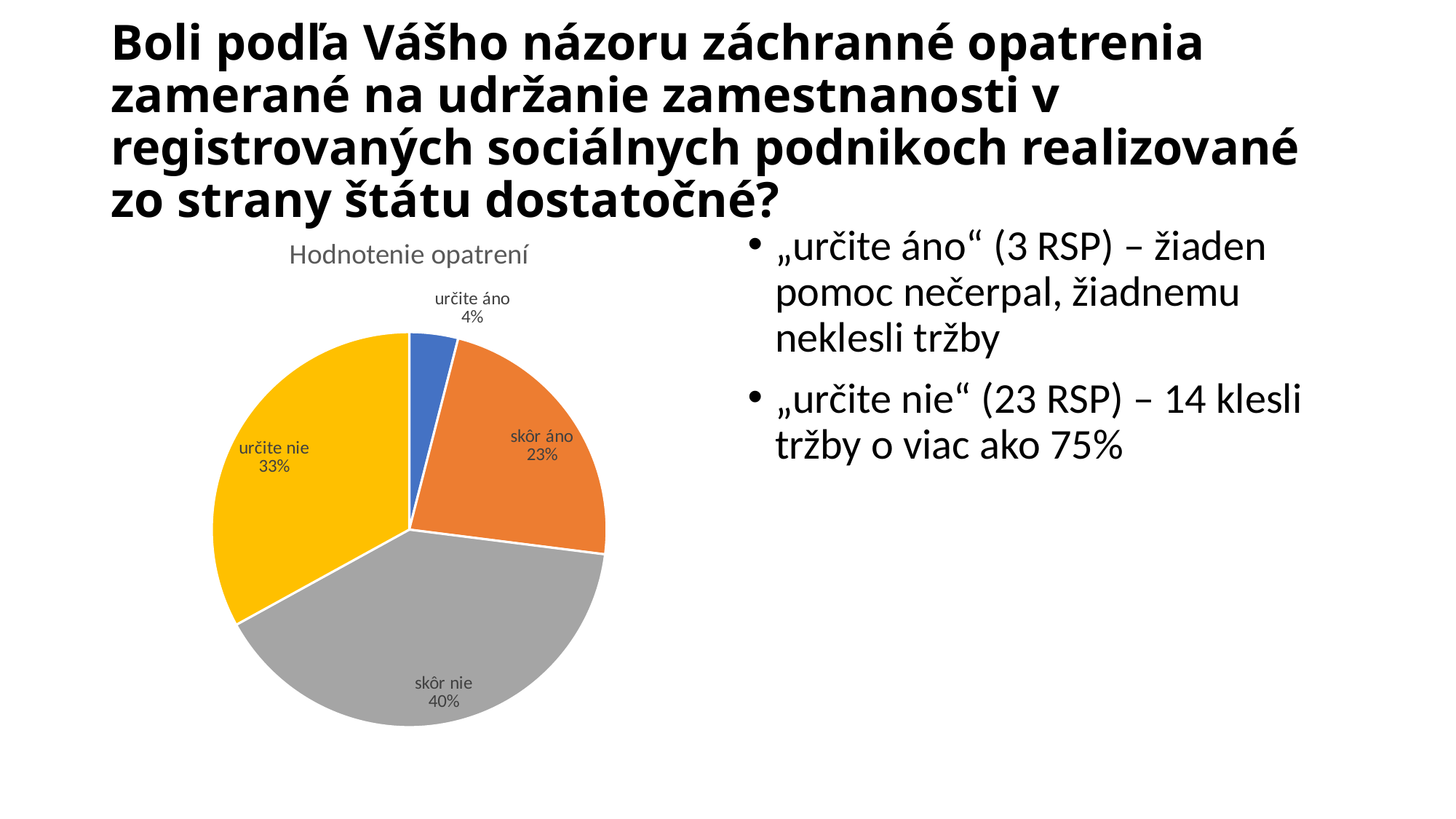
Which is larger, the slice for "určite nie" or the slice for "skôr áno"? určite nie What colour is the slice for "určite nie"? yellow What share of the pie does "skôr nie" take? 40% What kind of chart is shown on the slide? pie chart Which category has the largest slice of the pie? skôr nie What is the value shown for "skôr áno"? 23% What share of the pie does "určite áno" take? 4% How many categories are shown in the pie chart? 4 What is the difference in percentage points between "skôr nie" and "skôr áno"? 17 What is the value shown for "určite nie"? 33% Which category has the smallest slice of the pie? určite áno What is the title of the chart? Hodnotenie opatrení